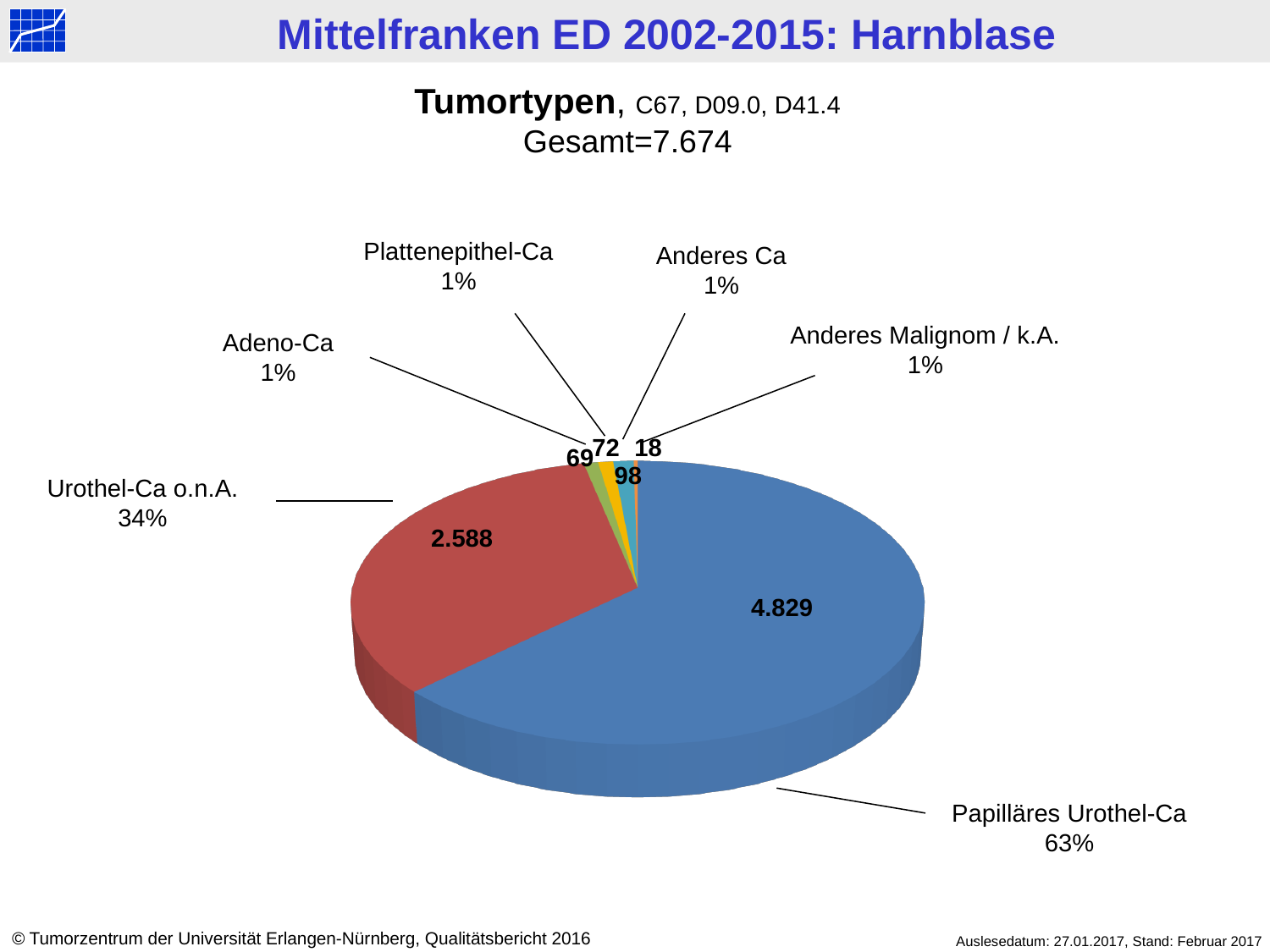
What is the title of the chart? Tumortypen, C67, D09.0, D41.4 What is the value for Papilläres Urothel-Ca? 4.829 What kind of chart is shown on the slide? pie chart What is the value for Urothel-Ca o.n.A.? 2.588 What total (Gesamt) is stated for the chart? 7.674 What is the difference between the values for Papilläres Urothel-Ca and Urothel-Ca o.n.A.? 2.241 What share of the pie does Papilläres Urothel-Ca represent? 63% What share of the pie does Adeno-Ca represent? 1% What share of the pie does Urothel-Ca o.n.A. represent? 34% Which category has the largest slice? Papilläres Urothel-Ca Which is larger, the value for Urothel-Ca o.n.A. or the value for Plattenepithel-Ca? Urothel-Ca o.n.A. How many categories (slices) does the pie chart show? 6